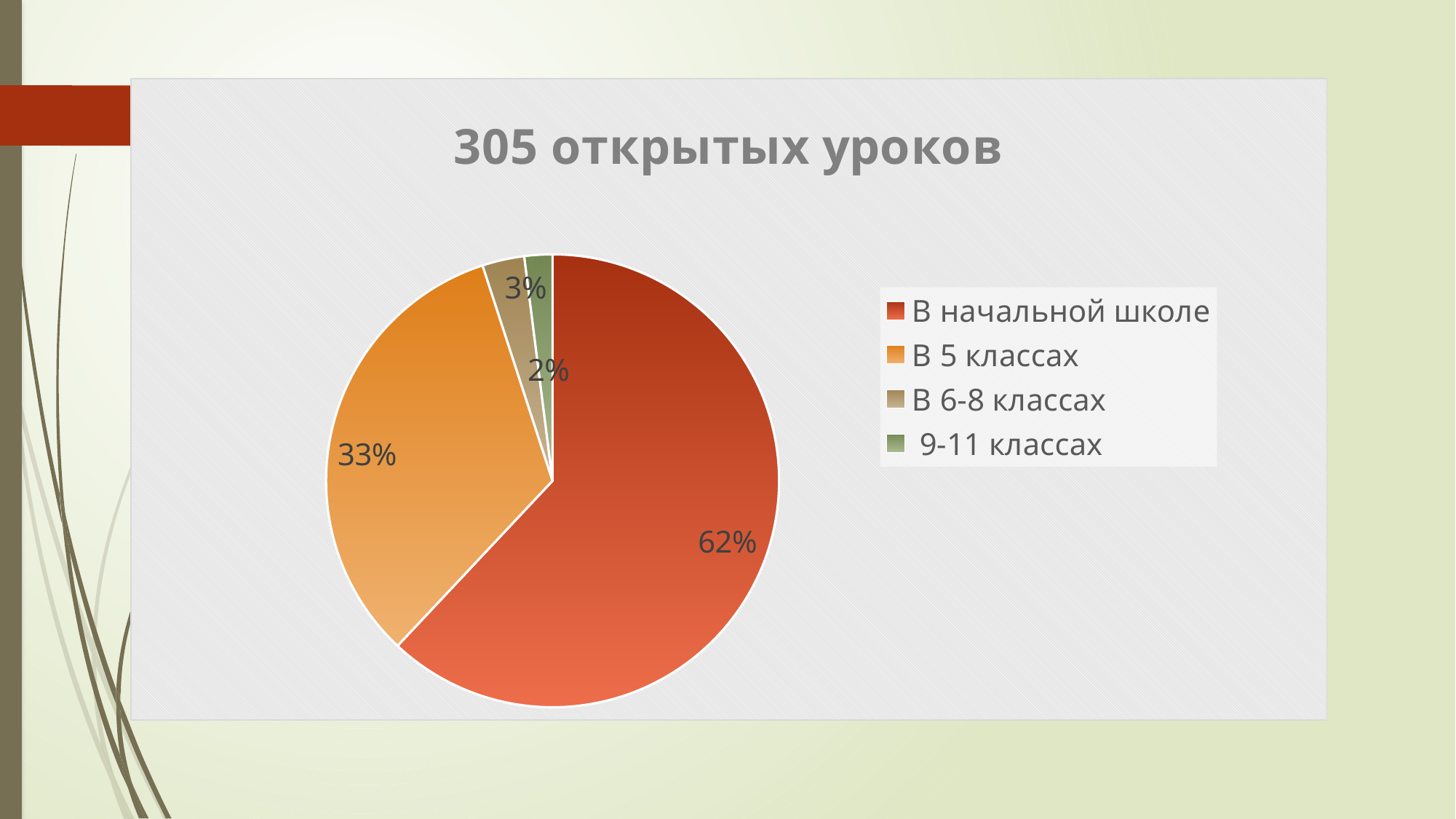
What share of the pie is labelled for '9-11 классах'? 2% What colour is the slice for 'В 5 классах'? orange How many categories does the legend list? 4 What share of the pie is labelled for 'В 5 классах'? 33% What is the difference in percentage points between 'В начальной школе' and 'В 5 классах'? 29 What is the title of the chart? 305 открытых уроков What share of the pie is labelled for 'В начальной школе'? 62% Which is larger, the slice for 'В 5 классах' or the slice for 'В 6-8 классах'? В 5 классах What kind of chart is shown on the slide? pie chart Which category has the smallest slice of the pie? 9-11 классах Which category has the largest slice of the pie? В начальной школе